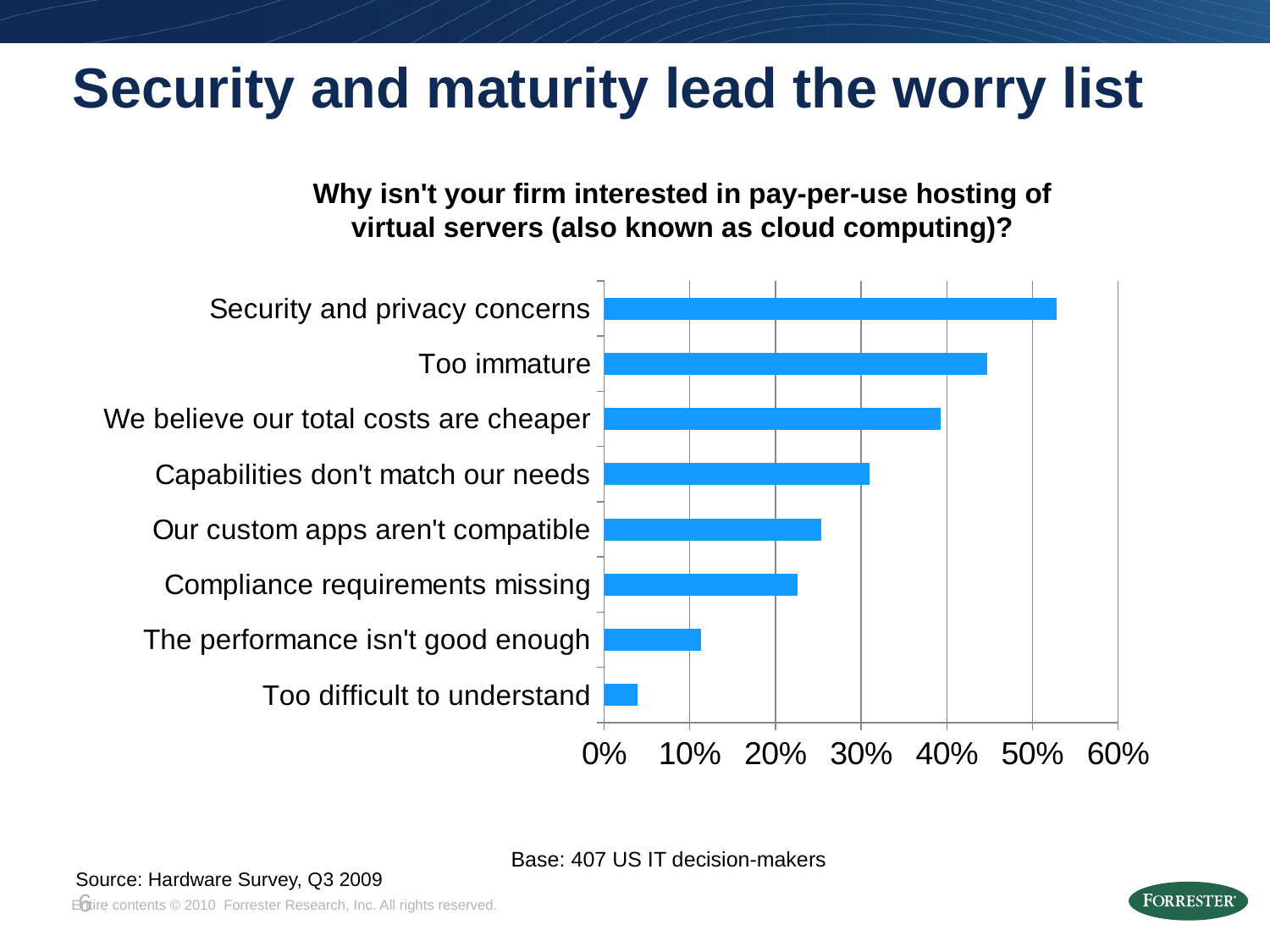
What is the base (number of respondents) stated below the chart? 407 US IT decision-makers Which is larger: the value for "The performance isn't good enough" or the value for "We believe our total costs are cheaper"? We believe our total costs are cheaper Which is larger: the value for "Too immature" or the value for "Compliance requirements missing"? Too immature Is the value for "Capabilities don't match our needs" greater or less than 40%? less Is the value for "Too difficult to understand" greater or less than 10%? less Is the value for "Our custom apps aren't compatible" greater or less than 30%? less What type of chart is shown on the slide? Bar chart Which reason has the lowest value in the chart? Too difficult to understand Which reason has the highest value in the chart? Security and privacy concerns How many reasons (categories) are plotted in the chart? 8